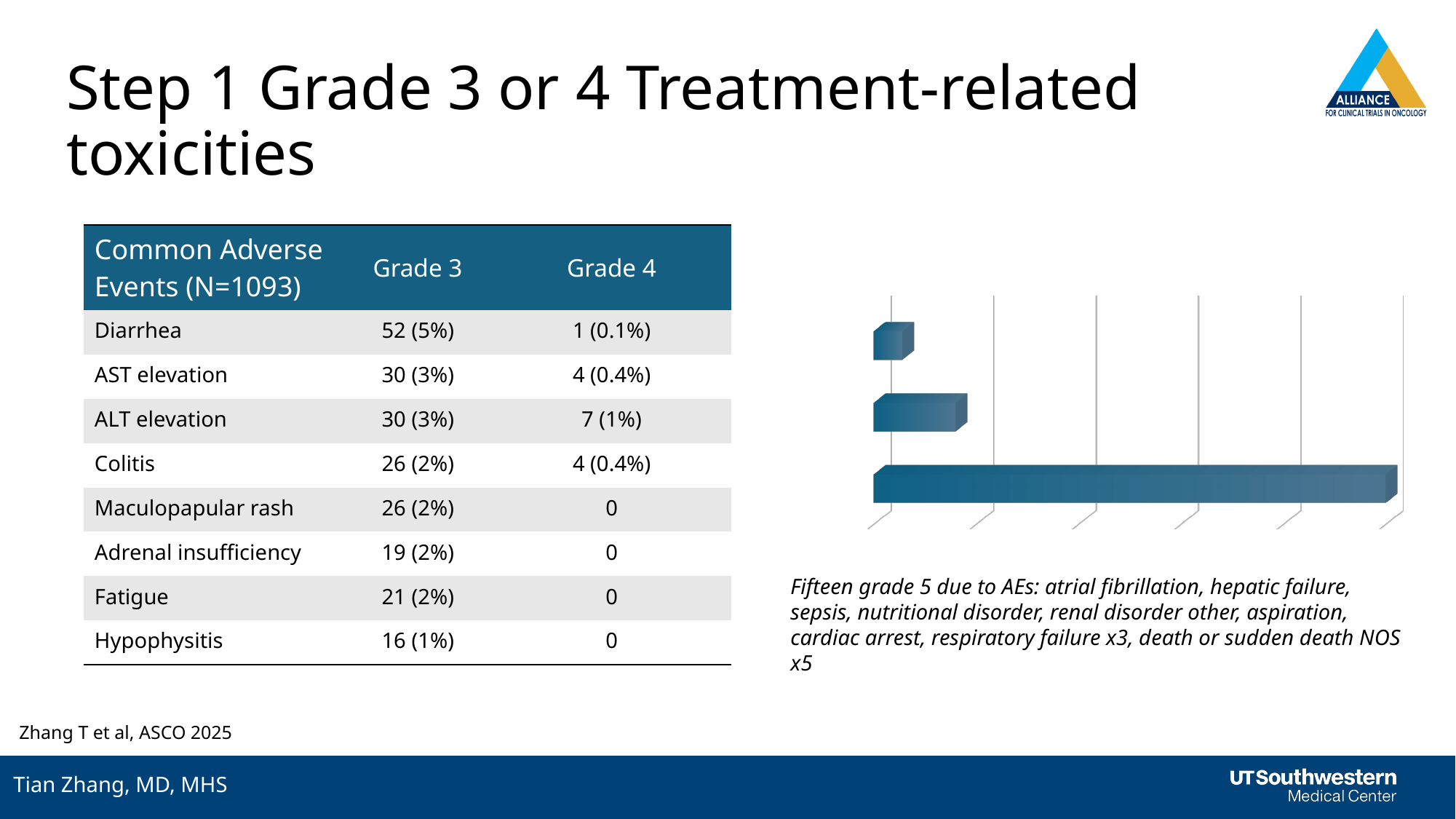
In the chart on the right side of the slide, is the middle bar longer or shorter than the bottom bar? shorter How many bars does the chart on the right side of the slide contain? 3 In the chart on the right side of the slide, which bar is the longest: the top, middle, or bottom bar? bottom What kind of chart is shown on the right side of the slide? bar chart Does the chart on the right side of the slide display a legend? No In the chart on the right side of the slide, which bar is the shortest: the top, middle, or bottom bar? top Are the bars in the chart on the right side of the slide oriented horizontally or vertically? horizontally